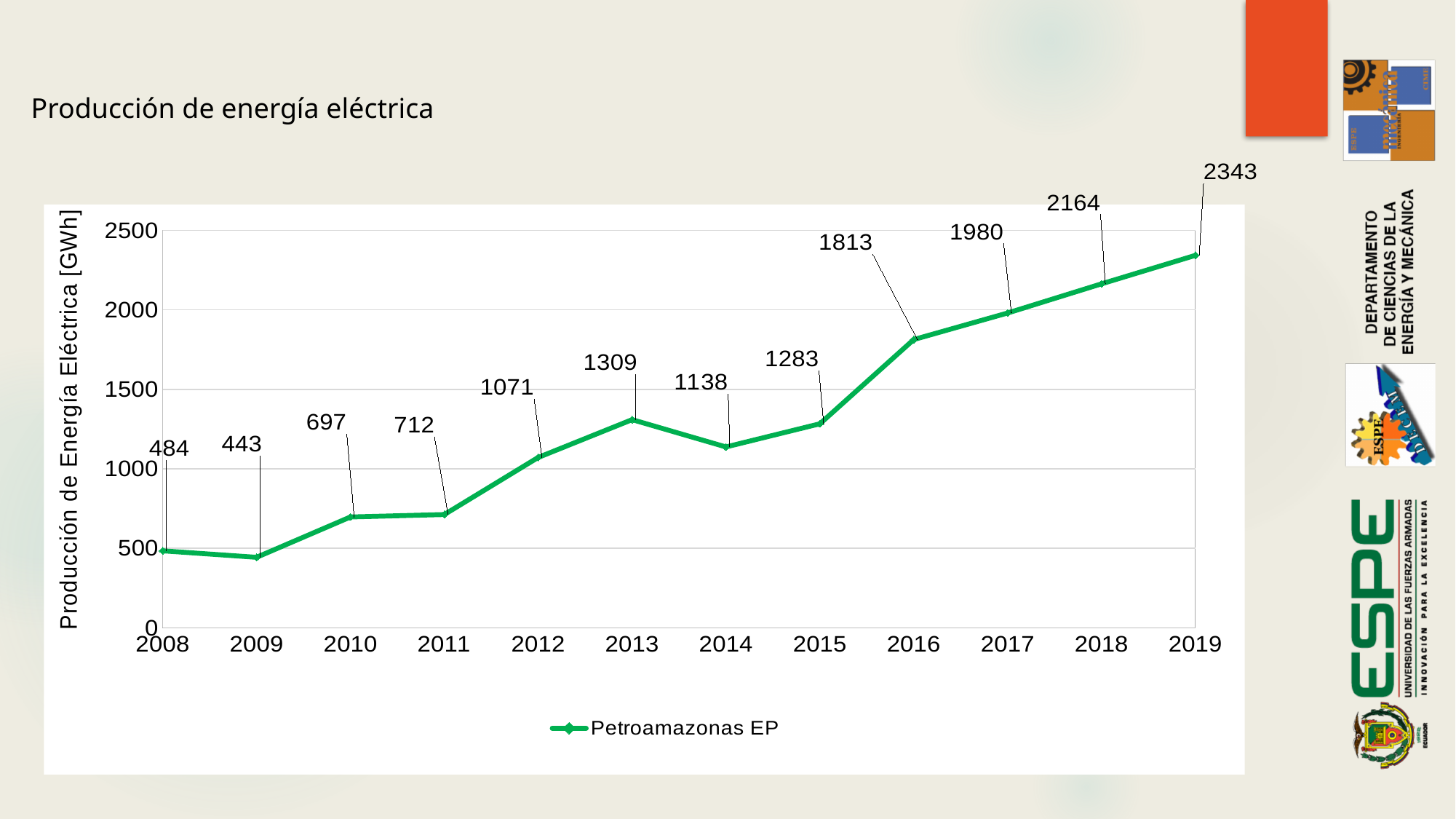
What was the electricity production of Petroamazonas EP in 2013? 1309 What value is shown for 2019? 2343 What was the production in 2009? 443 Is the value for 2016 greater or less than 1500? greater What is the difference between the 2019 value and the 2018 value? 179 What series name does the legend show? Petroamazonas EP Which year has the lowest electricity production? 2009 What kind of chart is shown on the slide? Line chart How many years are plotted on the x axis? 12 Which is larger, the value for 2011 or the value for 2010? 2011 By how much did production fall from 2013 to 2014? 171 Which year has the highest electricity production? 2019